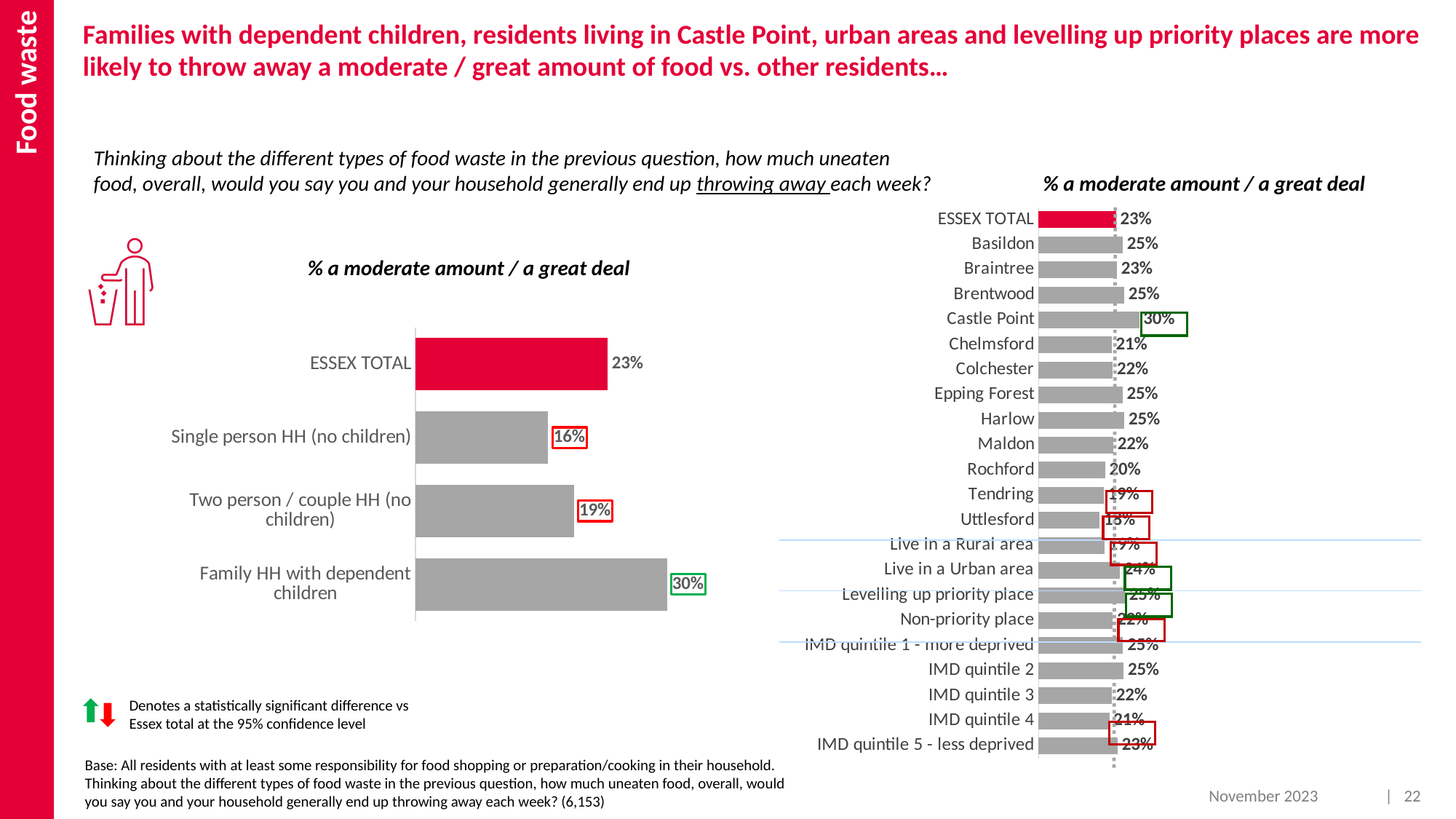
On the left chart, how many categories are shown? 4 On the right chart, which is larger, Basildon or Chelmsford? Basildon On the right chart, what is the value for Rochford? 20% On the left chart, what is the value for Family HH with dependent children? 30% On the right chart, which district has the highest value? Castle Point On the left chart, what is the difference between Family HH with dependent children and ESSEX TOTAL? 7 percentage points On the left chart, what is the value for Single person HH (no children)? 16% On the right chart, what is the value for IMD quintile 3? 22% On the right chart, what is the difference between Castle Point and Chelmsford? 9 percentage points On the right chart, what is the value for Castle Point? 30% On the left chart, which category has the lowest value? Single person HH (no children) What type of chart is used on the left of the slide? Bar chart